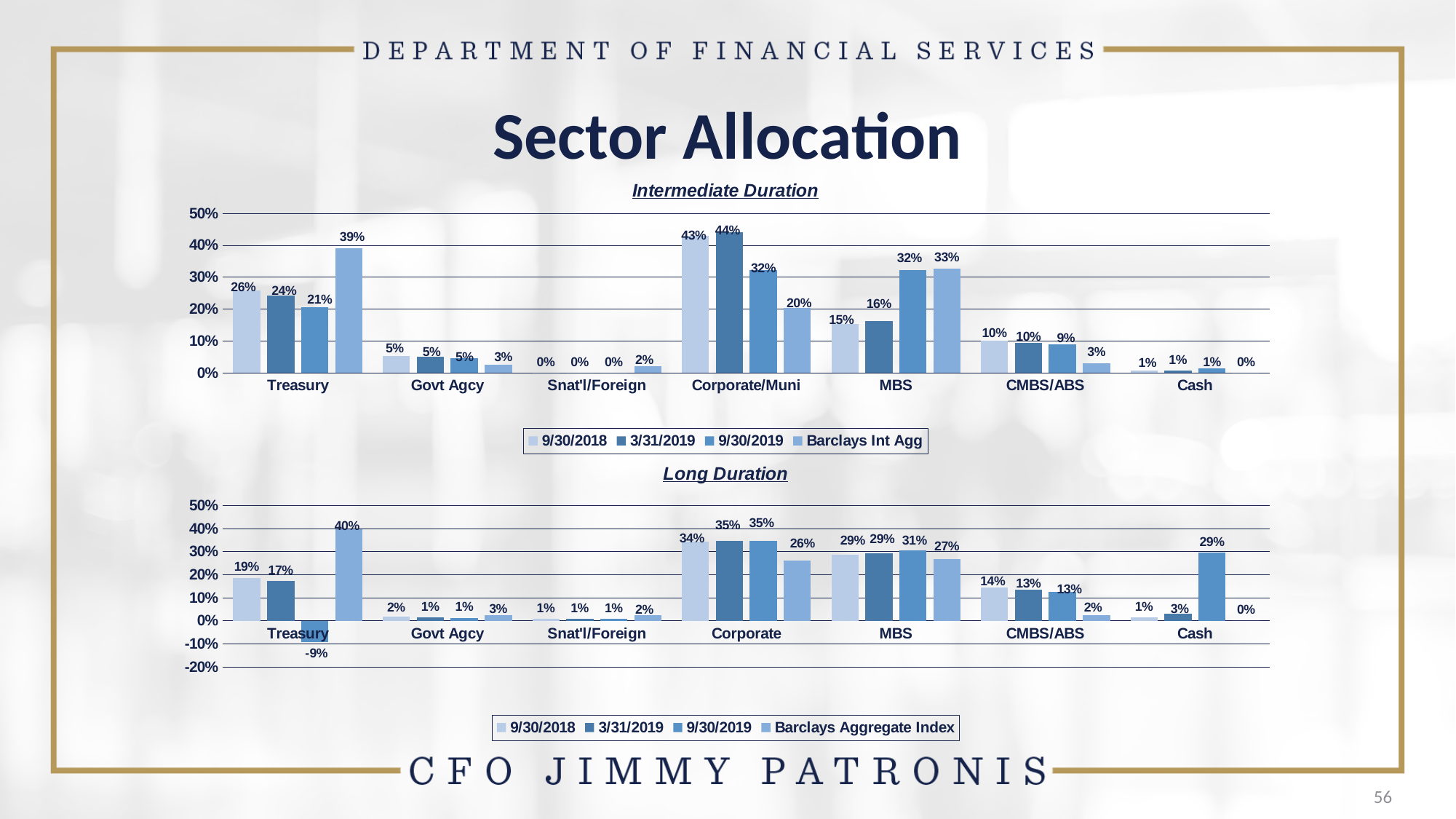
In the Intermediate Duration chart, what is the difference between the 9/30/2018 and 9/30/2019 values for Treasury? 5% In the Intermediate Duration chart, what is the Barclays Int Agg value for Treasury? 39% In the Intermediate Duration chart, what is the value for Corporate/Muni in the 3/31/2019 series? 44% In the Long Duration chart, which category has the lowest value in the 9/30/2019 series? Treasury How many series does the legend of the Long Duration chart list? 4 What type of chart is the Long Duration chart? Bar chart In the Long Duration chart, what is the value for Cash in the 9/30/2019 series? 29% In the Intermediate Duration chart, which category has the highest value in the 9/30/2018 series? Corporate/Muni How many categories are shown on the x axis of the Intermediate Duration chart? 7 In the Intermediate Duration chart, what is the difference between the 9/30/2019 and 9/30/2018 values for MBS? 17% In the Long Duration chart, which is larger for Corporate: the 9/30/2018 value or the Barclays Aggregate Index value? 9/30/2018 In the Long Duration chart, what is the value for Treasury in the 9/30/2019 series? -9%